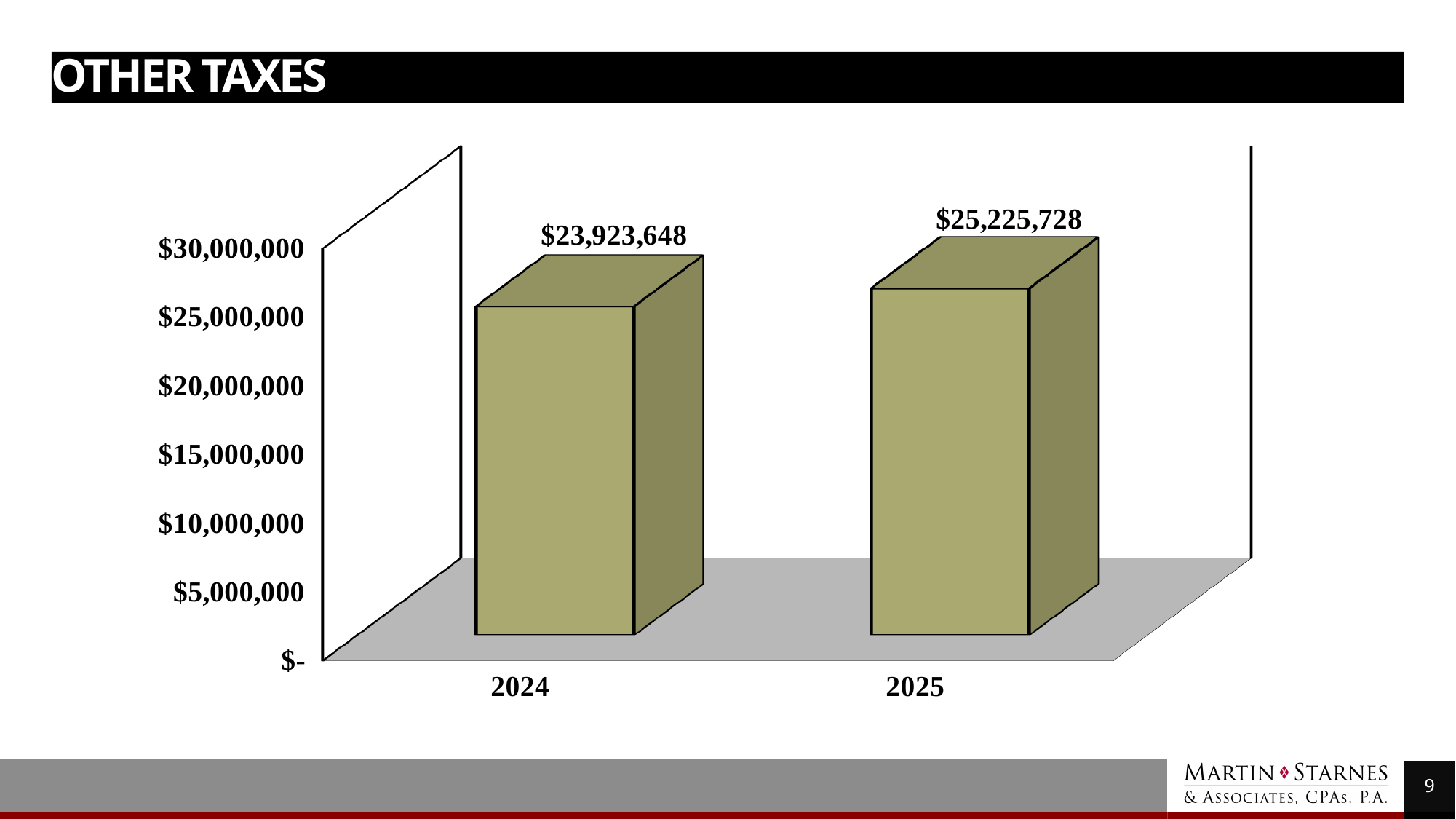
Is the value for 2025 greater or less than $30,000,000? less Is the value for 2024 greater or less than $20,000,000? greater What is the value for 2025? $25,225,728 Do the values rise or fall from 2024 to 2025? Rise Which year has the higher value? 2025 Which year has the lower value? 2024 How many years are shown on the chart? 2 Is the value for 2025 larger than the value for 2024? Yes What is the difference between the 2025 and 2024 values? $1,302,080 What kind of chart is shown on the slide? Bar chart What is the value for 2024? $23,923,648 What is the title of the slide? OTHER TAXES